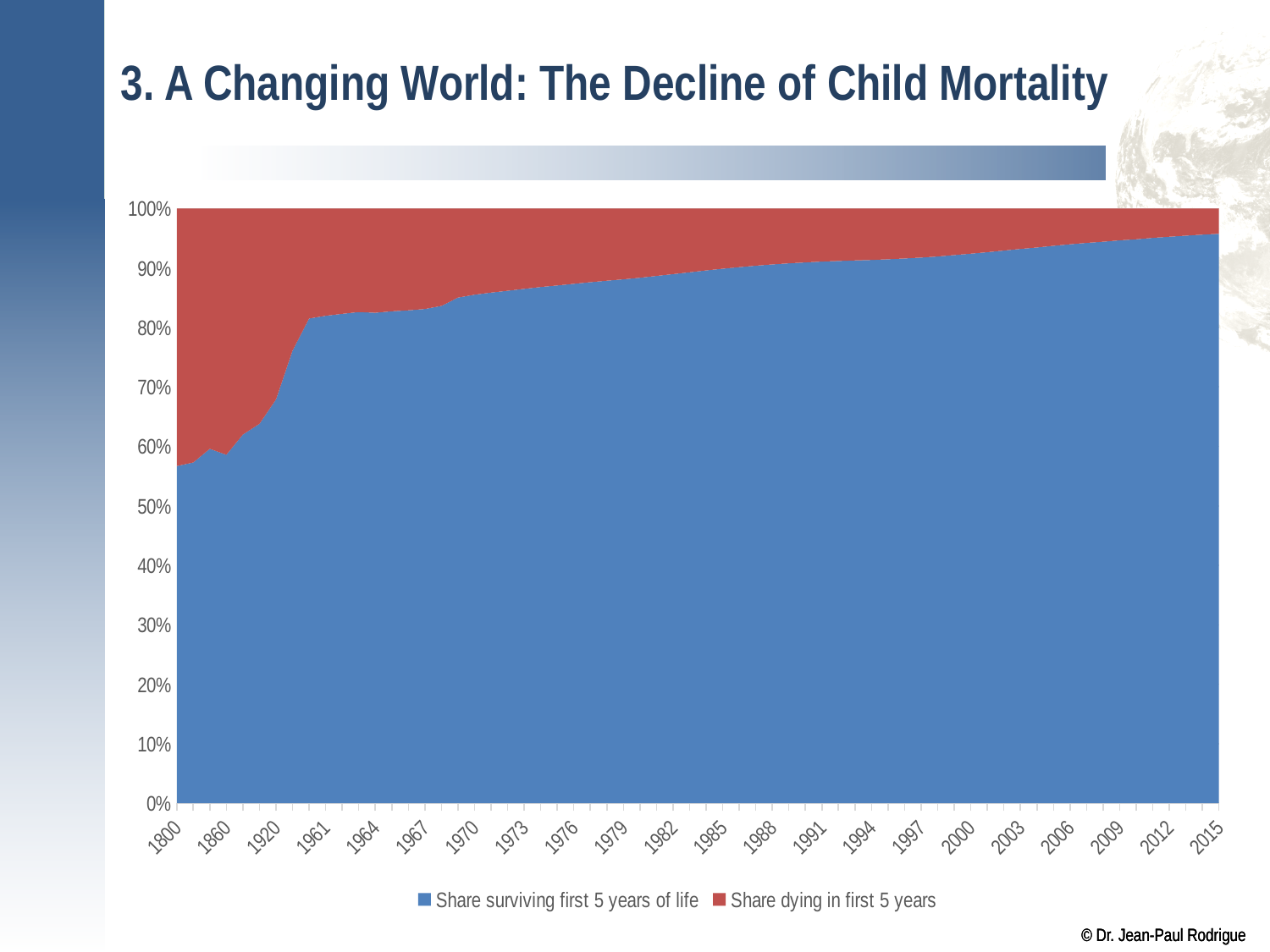
Does the share dying in the first 5 years rise or fall from 1800 to 2015? fall What kind of chart is shown on the slide? area chart Does the share surviving the first 5 years of life rise or fall from 1800 to 2015? rise How many series does the legend list? 2 Which colour represents the series 'Share dying in first 5 years'? red Which series is larger in 2015, 'Share surviving first 5 years of life' or 'Share dying in first 5 years'? Share surviving first 5 years of life Is the value for 'Share surviving first 5 years of life' in 1920 greater or less than 70%? less What is the title of the slide containing the chart? 3. A Changing World: The Decline of Child Mortality Is the value for 'Share surviving first 5 years of life' in 1961 greater or less than 80%? greater Is the value for 'Share surviving first 5 years of life' in 1970 greater or less than 80%? greater